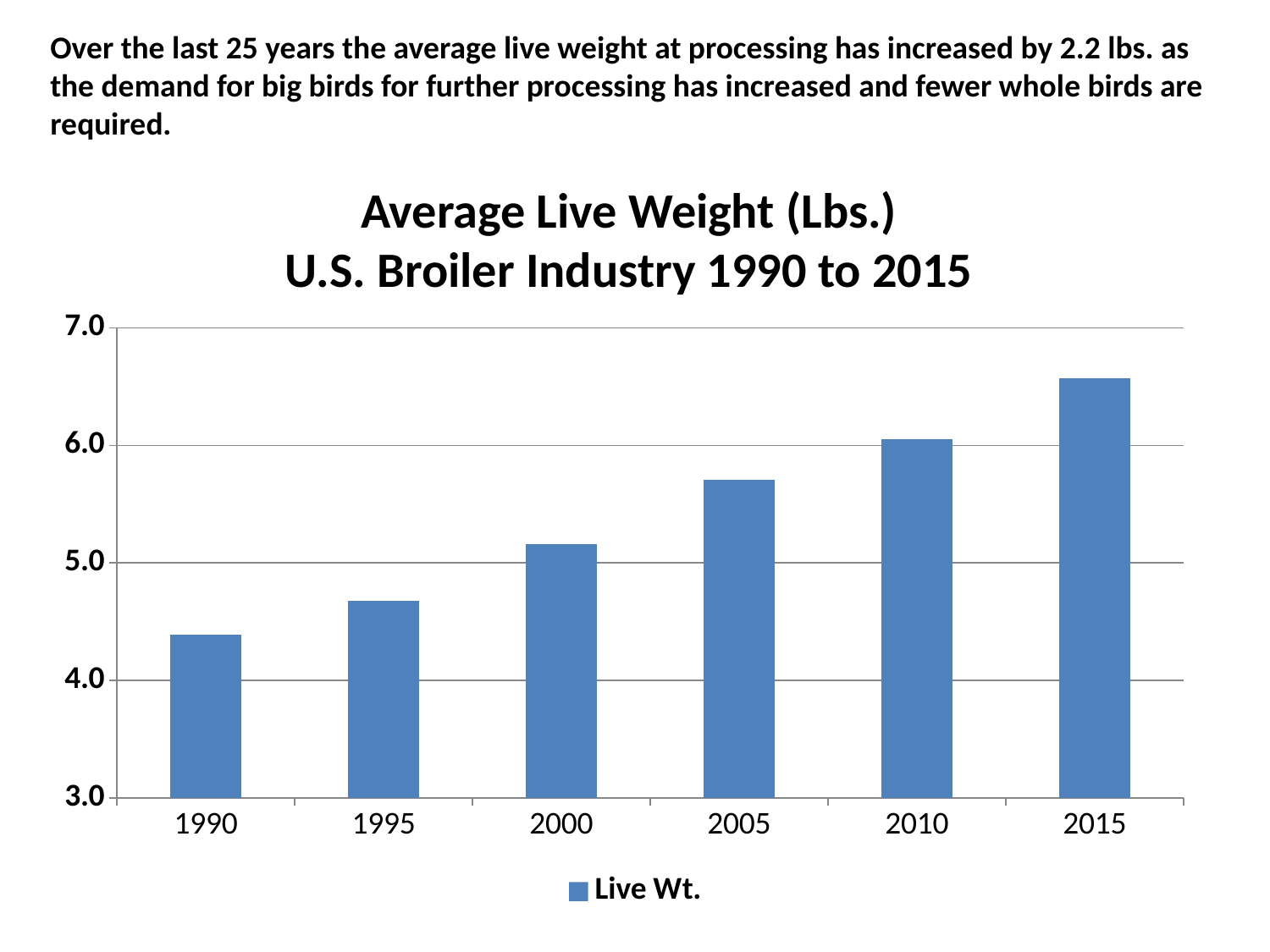
Which year has the lowest average live weight? 1990 How many series does the legend list? 1 Is the value for 2015 greater or less than 6.0? greater How many years are plotted on the x axis? 6 Is the value for 1990 greater or less than 5.0? less Do the values rise or fall from 1990 to 2015? rise What is the name of the series shown in the legend? Live Wt. Which is larger, the value for 2000 or the value for 2010? 2010 Which year has the highest average live weight? 2015 What kind of chart is shown on the slide? bar chart Is the value for 2005 greater or less than 6.0? less What is the title of the chart? Average Live Weight (Lbs.) U.S. Broiler Industry 1990 to 2015